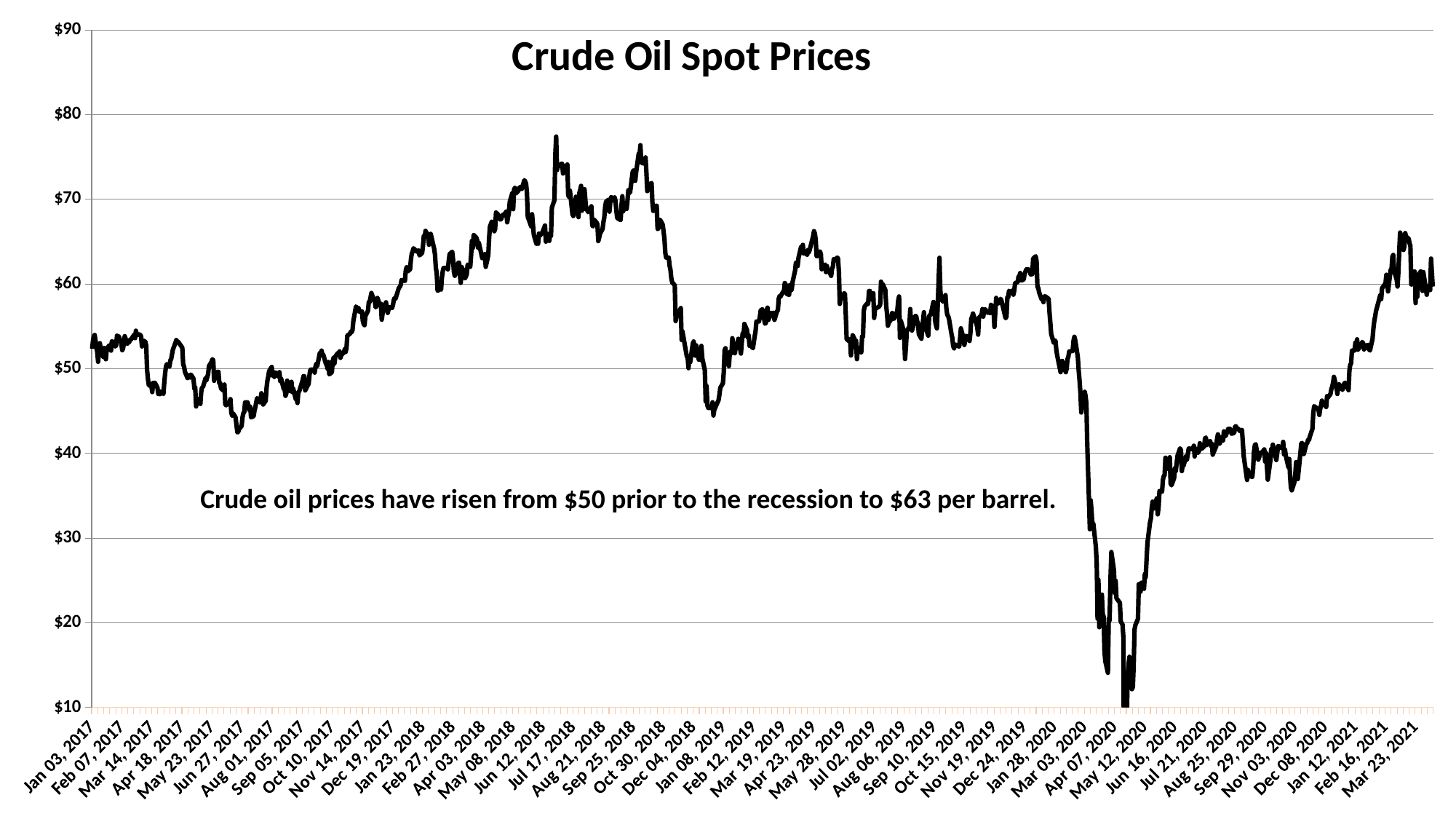
What is the title of the chart? Crude Oil Spot Prices What kind of chart is shown on the slide? line chart Is the value around Jun 27, 2017 greater or less than $50? less In which year does the highest value on the chart occur? 2018 Do the values rise or fall from Apr 07, 2020 to Mar 23, 2021? rise In which year does the lowest value on the chart occur? 2020 According to the annotation on the chart, what price per barrel have crude oil prices risen to? $63 How many lines are plotted on the chart? 1 Is the value around Sep 29, 2020 greater or less than $50? less According to the annotation on the chart, what was the crude oil price prior to the recession? $50 Is the value around Apr 07, 2020 greater or less than $30? less